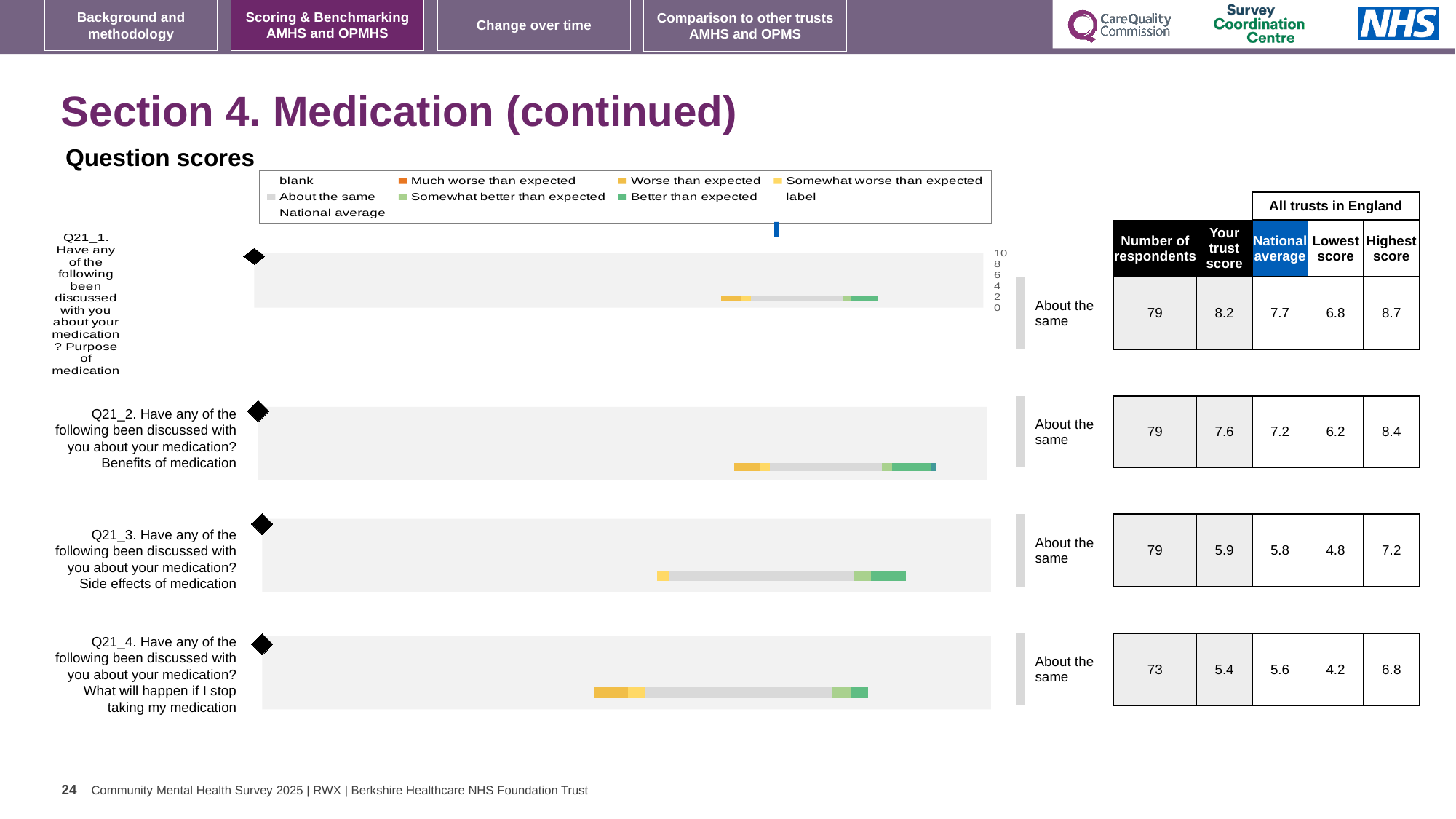
How many question rows (charts) are shown on the slide? 4 For Q21_4, which is larger: the trust score or the national average? National average For Q21_1 (Purpose of medication), what is the difference between the trust score and the national average? 0.5 What is the 'Your trust score' for Q21_2 (Benefits of medication)? 7.6 What benchmark category is given for Q21_3 (Side effects of medication)? About the same What is the national average for Q21_3 (Side effects of medication)? 5.8 What is the highest score among all trusts in England for Q21_2 (Benefits of medication)? 8.4 Which question has the lowest 'Your trust score'? Q21_4 (What will happen if I stop taking my medication) Which question has the highest 'Your trust score'? Q21_1 (Purpose of medication) What kind of chart is used to show the question scores on this slide? bar chart How many respondents are listed for Q21_4 (What will happen if I stop taking my medication)? 73 Which legend entry is shown in orange? Much worse than expected